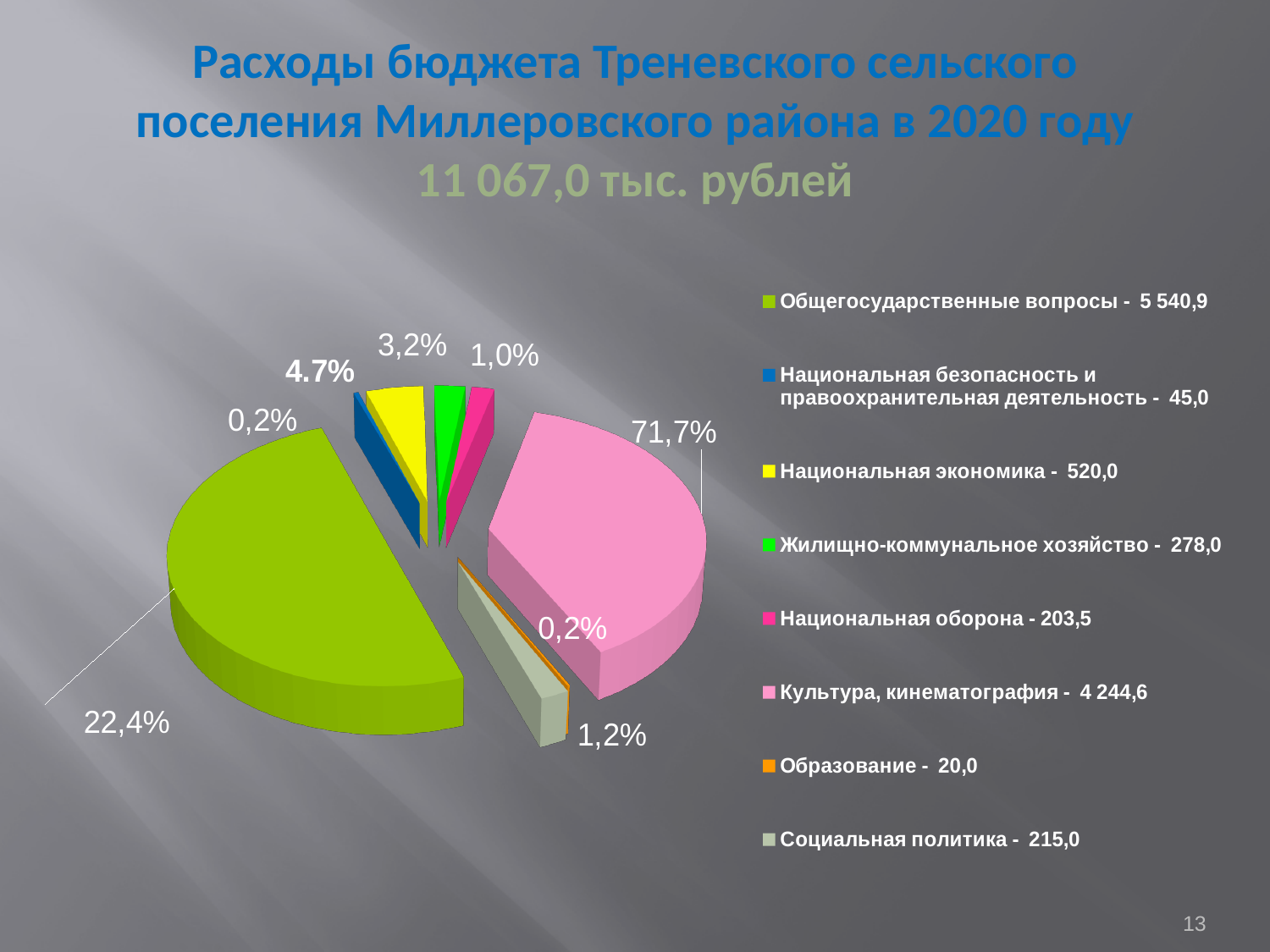
What total amount of expenditure is stated in the slide title? 11 067,0 тыс. рублей What is the difference between the legend values for Национальная экономика and Жилищно-коммунальное хозяйство? 242,0 What kind of chart is shown on the slide? pie chart Which category has the largest value in the legend? Общегосударственные вопросы How many categories does the legend of the pie chart list? 8 Which category has the smallest value in the legend? Образование What value is shown in the legend for Национальная экономика? 520,0 What value is shown in the legend for Образование? 20,0 What value is shown in the legend for Жилищно-коммунальное хозяйство? 278,0 Which is larger: Национальная оборона or Социальная политика? Социальная политика What value is shown in the legend for Культура, кинематография? 4 244,6 What colour is the slice for Культура, кинематография? pink